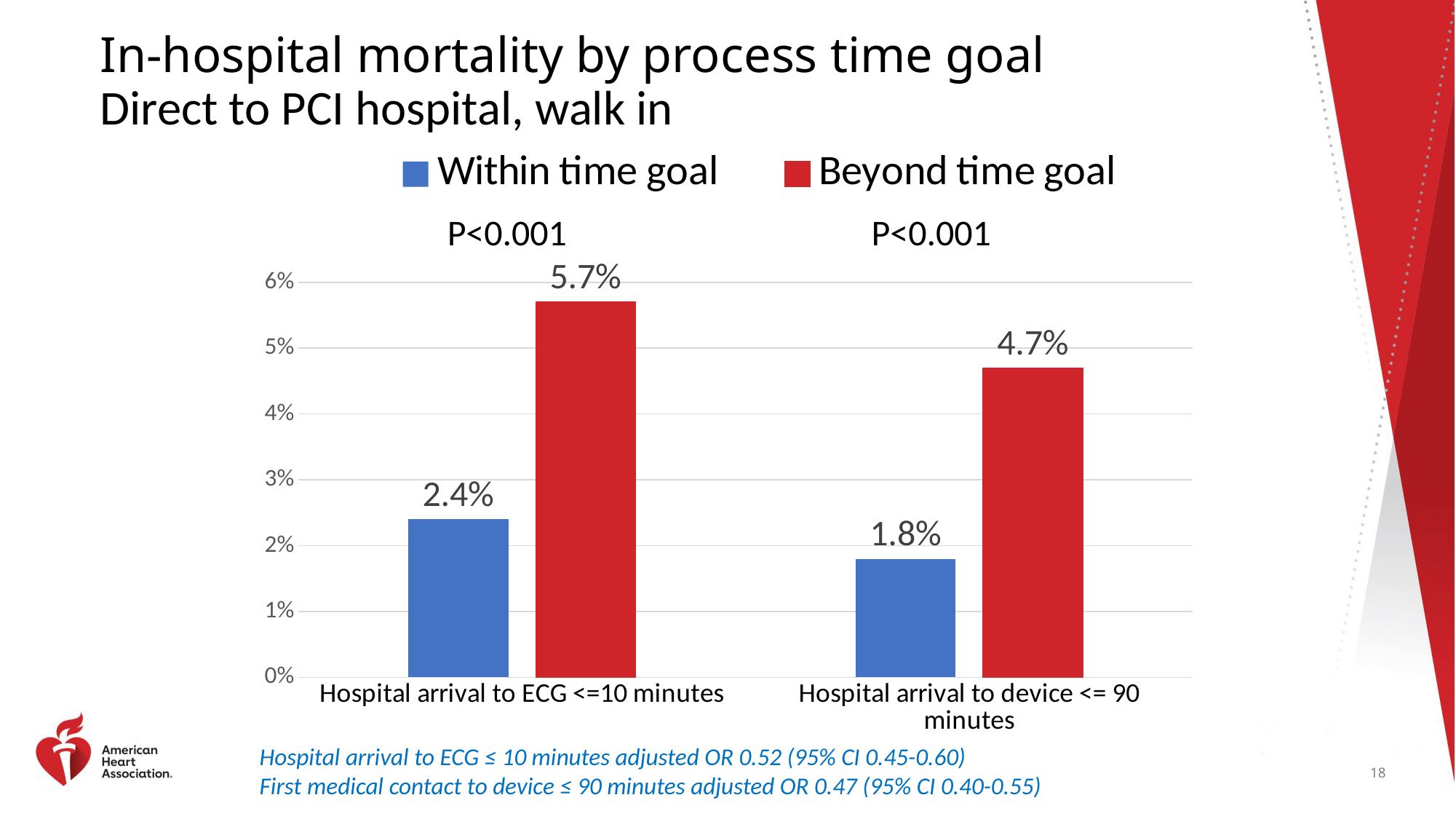
Is mortality higher within or beyond the time goal for Hospital arrival to device <= 90 minutes? Beyond time goal What is the in-hospital mortality for patients within the time goal for Hospital arrival to ECG <=10 minutes? 2.4% What is the in-hospital mortality for patients within the time goal for Hospital arrival to device <= 90 minutes? 1.8% What is the difference in mortality between beyond and within the time goal for Hospital arrival to device <= 90 minutes? 2.9% What type of chart is shown on the slide? Bar chart What is the in-hospital mortality for patients beyond the time goal for Hospital arrival to device <= 90 minutes? 4.7% Which bar shows the lowest mortality on the chart? Within time goal, Hospital arrival to device <= 90 minutes (1.8%) What is the difference in mortality between beyond and within the time goal for Hospital arrival to ECG <=10 minutes? 3.3% How many series does the legend list? 2 What is the in-hospital mortality for patients beyond the time goal for Hospital arrival to ECG <=10 minutes? 5.7% Which bar shows the highest mortality on the chart? Beyond time goal, Hospital arrival to ECG <=10 minutes (5.7%) What colour represents the Beyond time goal series? Red